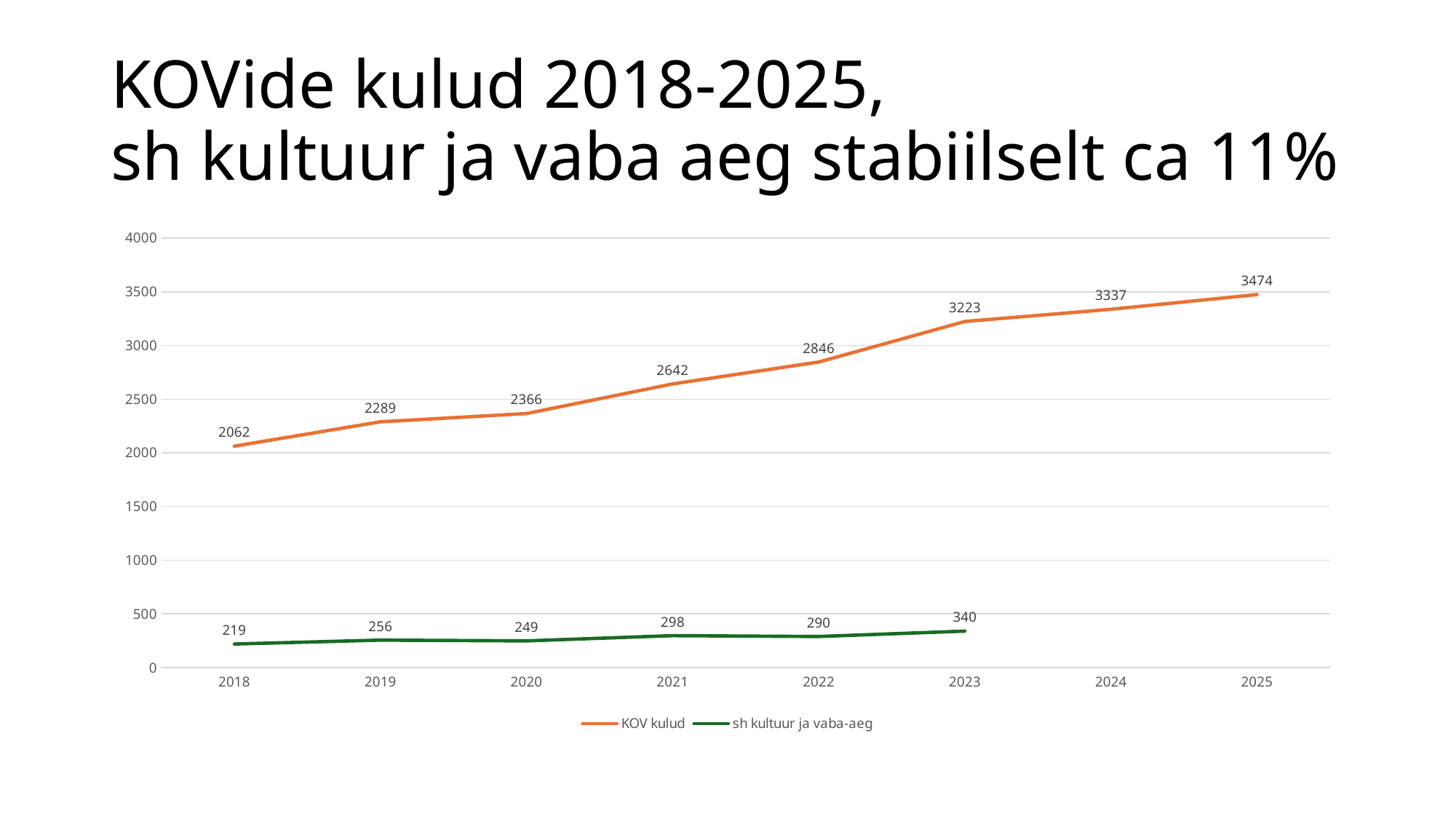
Which is larger: sh kultuur ja vaba-aeg in 2019 or in 2020? 2019 What is the value of KOV kulud in 2025? 3474 Is the value of KOV kulud in 2022 greater or less than 3000? less What is the difference between KOV kulud in 2025 and in 2018? 1412 How many years are shown on the x axis? 8 What is the value of KOV kulud in 2018? 2062 How many series does the legend list? 2 In which year is KOV kulud highest? 2025 What is the value of sh kultuur ja vaba-aeg in 2021? 298 In which year is sh kultuur ja vaba-aeg lowest? 2018 What kind of chart is shown on the slide? line chart Does KOV kulud rise or fall from 2018 to 2025? rise